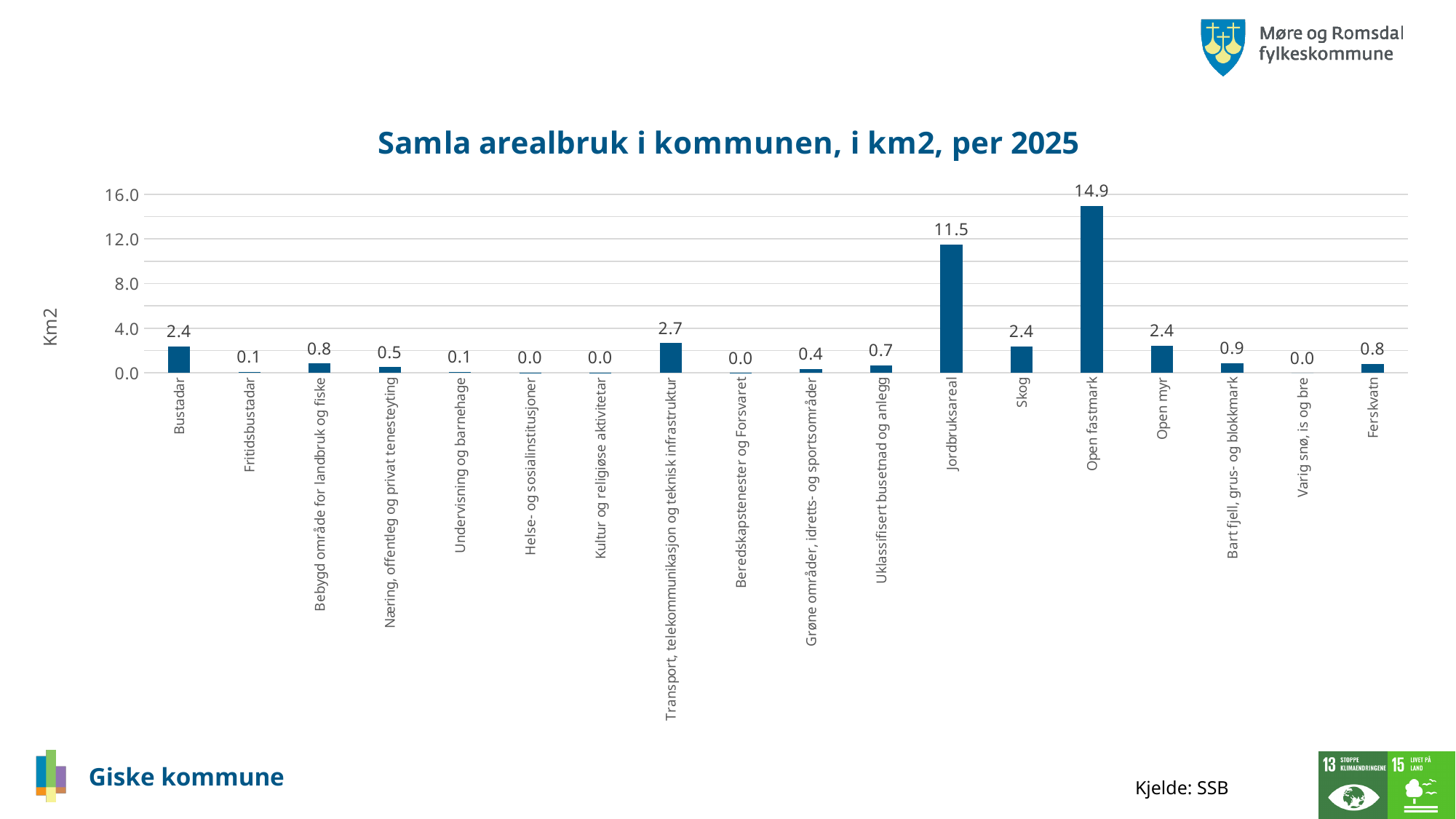
What is the value for Transport, telekommunikasjon og teknisk infrastruktur? 2.7 Is the value for Open fastmark greater or less than 12.0? greater What is the difference between the values for Open fastmark and Jordbruksareal? 3.4 Which is larger, the value for Jordbruksareal or the value for Skog? Jordbruksareal What is the value for Bustadar? 2.4 What kind of chart is shown on the slide? bar chart What is the title of the chart? Samla arealbruk i kommunen, i km2, per 2025 What is the value for Ferskvatn? 0.8 Which category has the highest value? Open fastmark What is the value for Open fastmark? 14.9 How many categories are shown on the x axis? 18 What is the value for Jordbruksareal? 11.5